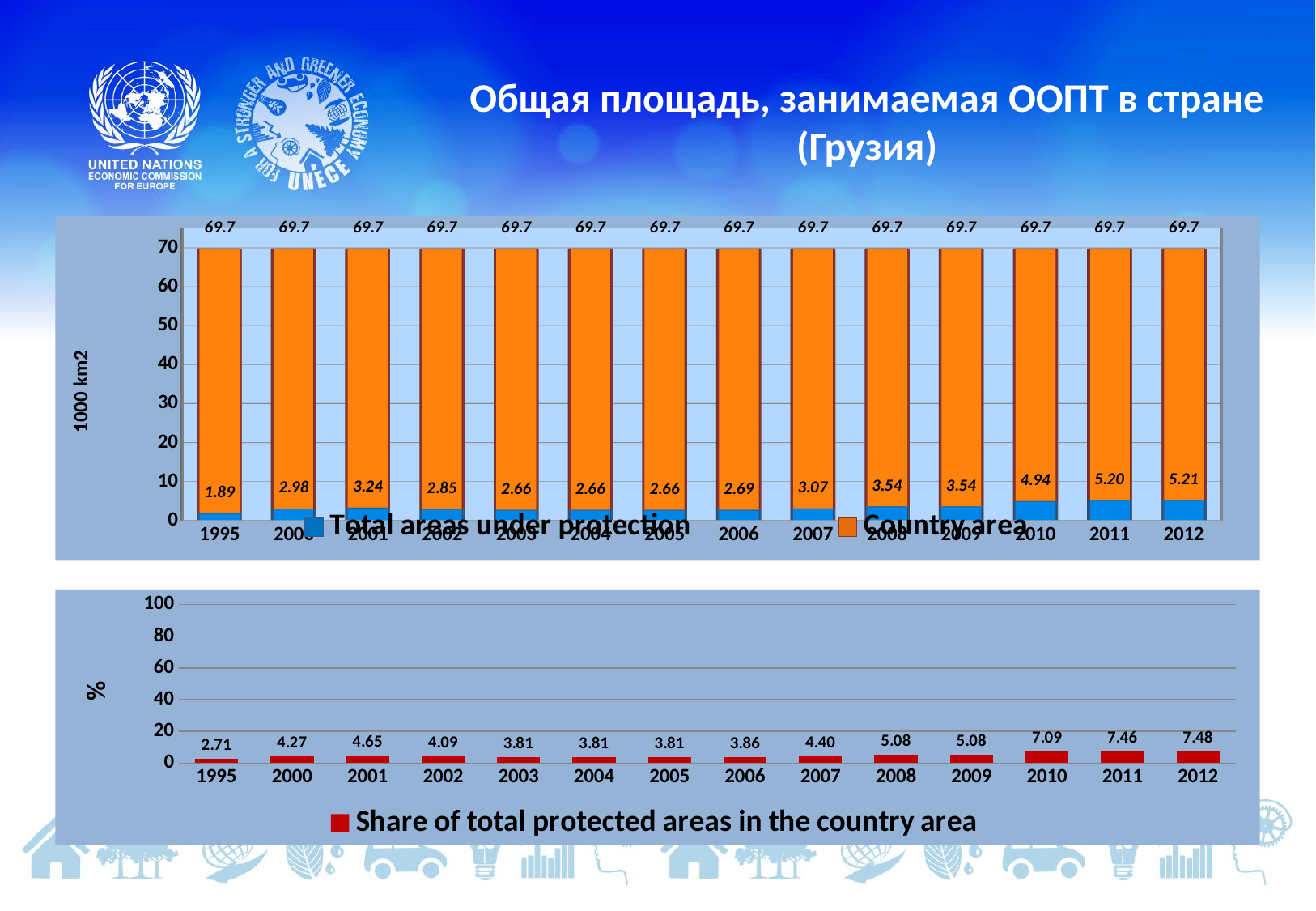
In the bottom chart, what is the share of total protected areas in the country area in 2010? 7.09 In the top chart, which year has the lowest value for Total areas under protection? 1995 In the top chart, how many years are shown on the x axis? 14 What type of chart is the bottom chart? Bar chart In the top chart, what is the value for Total areas under protection in 2012? 5.21 In the top chart, what is the value for Country area in 2005? 69.7 In the top chart, what is the y-axis unit label? 1000 km2 In the bottom chart, what is the difference between the share in 2011 and the share in 2008? 2.38 In the bottom chart, is the share in 2000 or in 2007 larger? 2007 In the top chart, how many series does the legend list? 2 In the bottom chart, which year has the highest share of total protected areas in the country area? 2012 In the top chart, what is the difference between Total areas under protection in 2012 and in 1995? 3.32